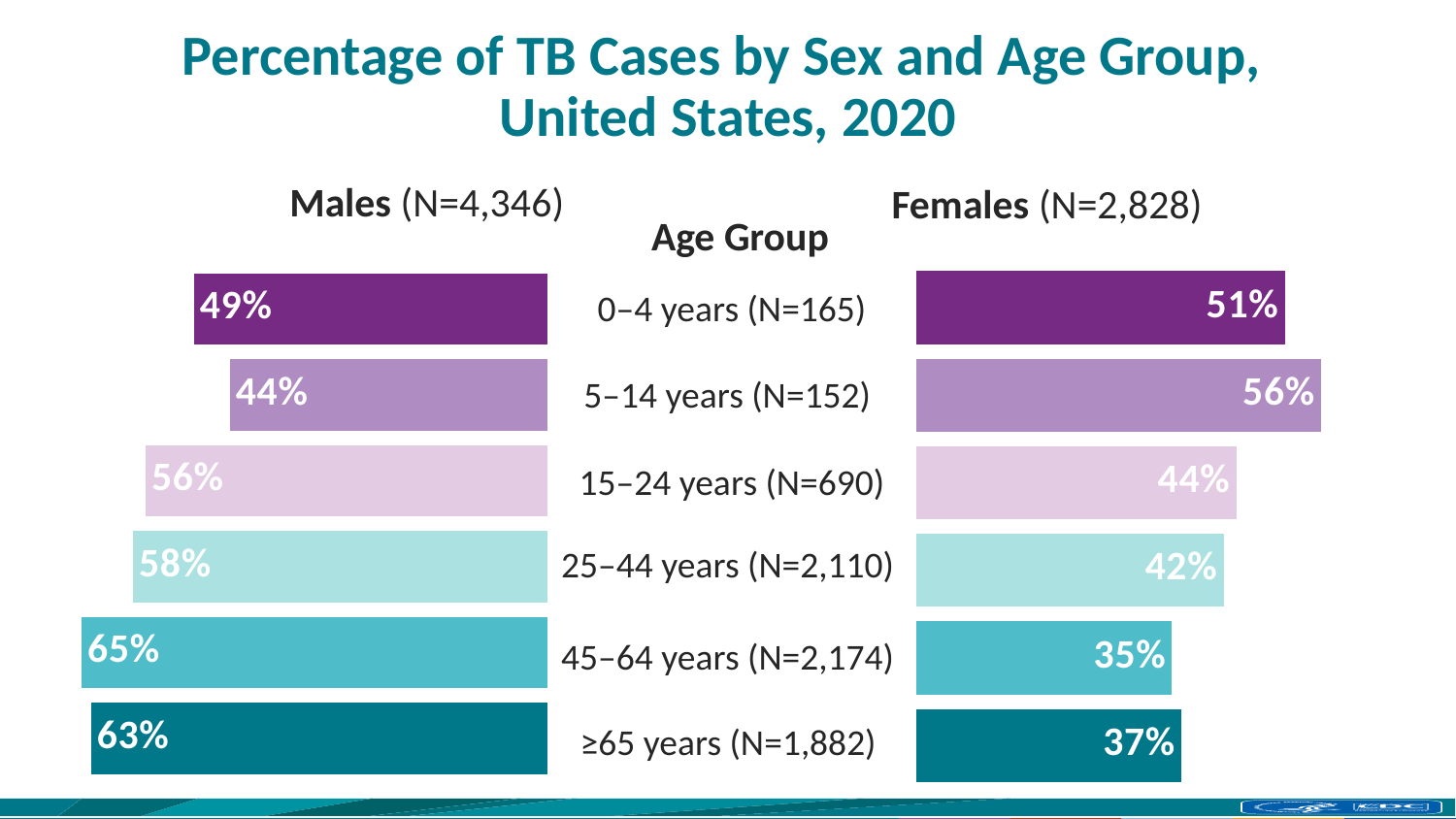
What is the title of the chart? Percentage of TB Cases by Sex and Age Group, United States, 2020 What is the total number of male TB cases (N) shown on the slide? 4,346 What is the difference between the male and female percentages in the 25–44 years age group? 16 percentage points Which age group has the highest percentage of male TB cases? 45–64 years What percentage of TB cases in the 45–64 years age group were males? 65% What percentage of TB cases in the ≥65 years age group were females? 37% What percentage of TB cases in the 5–14 years age group were females? 56% What percentage of TB cases in the 0–4 years age group were males? 49% What type of chart is shown on the slide? Bar chart Which age group has the lowest percentage of female TB cases? 45–64 years How many age groups are shown in the chart? 6 In the 15–24 years age group, is the male or female percentage larger? Male